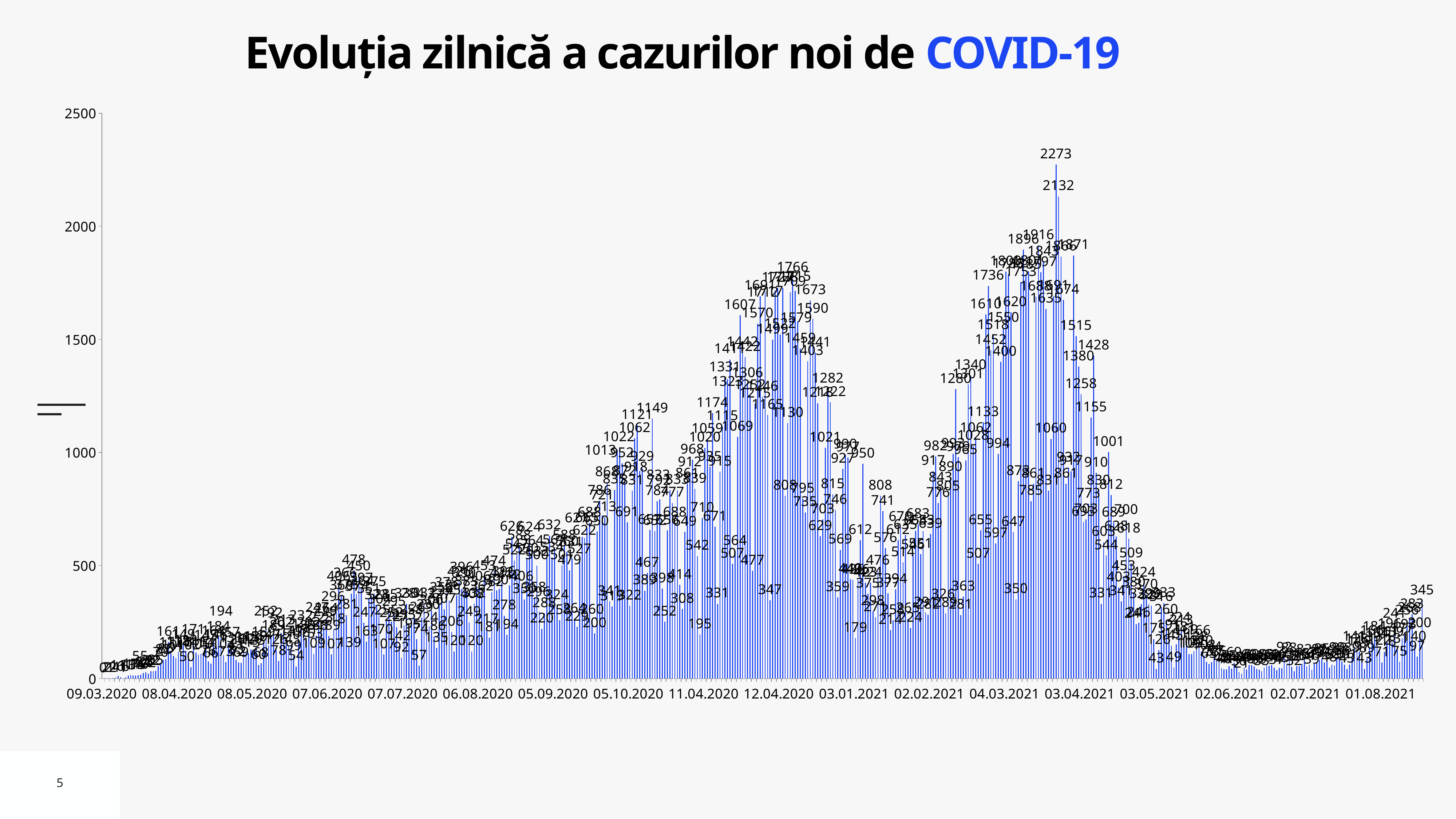
What is the first date label on the x axis? 09.03.2020 What is the highest tick value shown on the y axis? 2500 What is the title of the chart on the slide? Evoluția zilnică a cazurilor noi de COVID-19 What is the difference between the two highest labelled values, 2273 and 2132? 141 Do the values rise or fall between 02.07.2021 and 01.08.2021? rise What kind of chart is shown on the slide? bar chart Do the values rise or fall between 03.04.2021 and 02.06.2021? fall Is the highest value on the chart greater or less than 2000? greater What is the highest daily value labelled on the chart? 2273 Are the values around 03.05.2021 greater or less than 500? less Which is larger, the peak labelled 2273 or the neighbouring peak labelled 2132? 2273